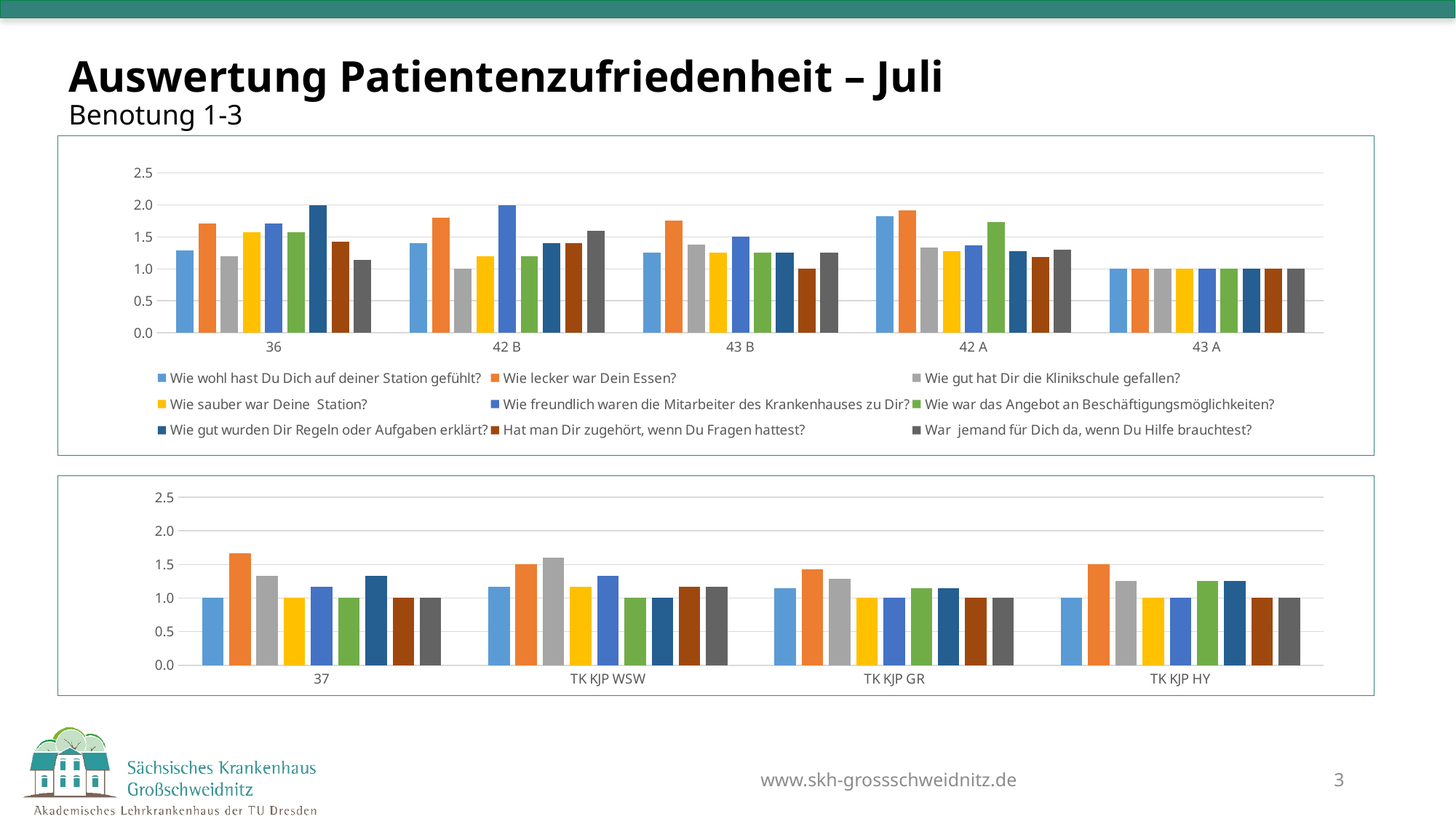
What is the title of the slide? Auswertung Patientenzufriedenheit – Juli In the top chart, is the value of "Wie lecker war Dein Essen?" for category 36 greater or less than 1.5? greater What kind of chart is the top chart on the slide? bar chart In the top chart, which series has the highest value for category 43 B? Wie lecker war Dein Essen? In the top chart, is the value of "Wie wohl hast Du Dich auf deiner Station gefühlt?" for category 42 A greater or less than 1.5? greater In the bottom chart, which series has the highest value for category 37? Wie lecker war Dein Essen? How many categories are shown on the x axis of the top chart? 5 In the top chart, for category 36, which is larger: "Wie gut wurden Dir Regeln oder Aufgaben erklärt?" or "Wie wohl hast Du Dich auf deiner Station gefühlt?" Wie gut wurden Dir Regeln oder Aufgaben erklärt? How many series does the legend of the top chart list? 9 How many categories are shown on the x axis of the bottom chart? 4 In the bottom chart, is the value of "Wie gut hat Dir die Klinikschule gefallen?" for TK KJP WSW greater or less than 1.5? greater In the top chart, which series has the highest value for category 42 B? Wie freundlich waren die Mitarbeiter des Krankenhauses zu Dir?